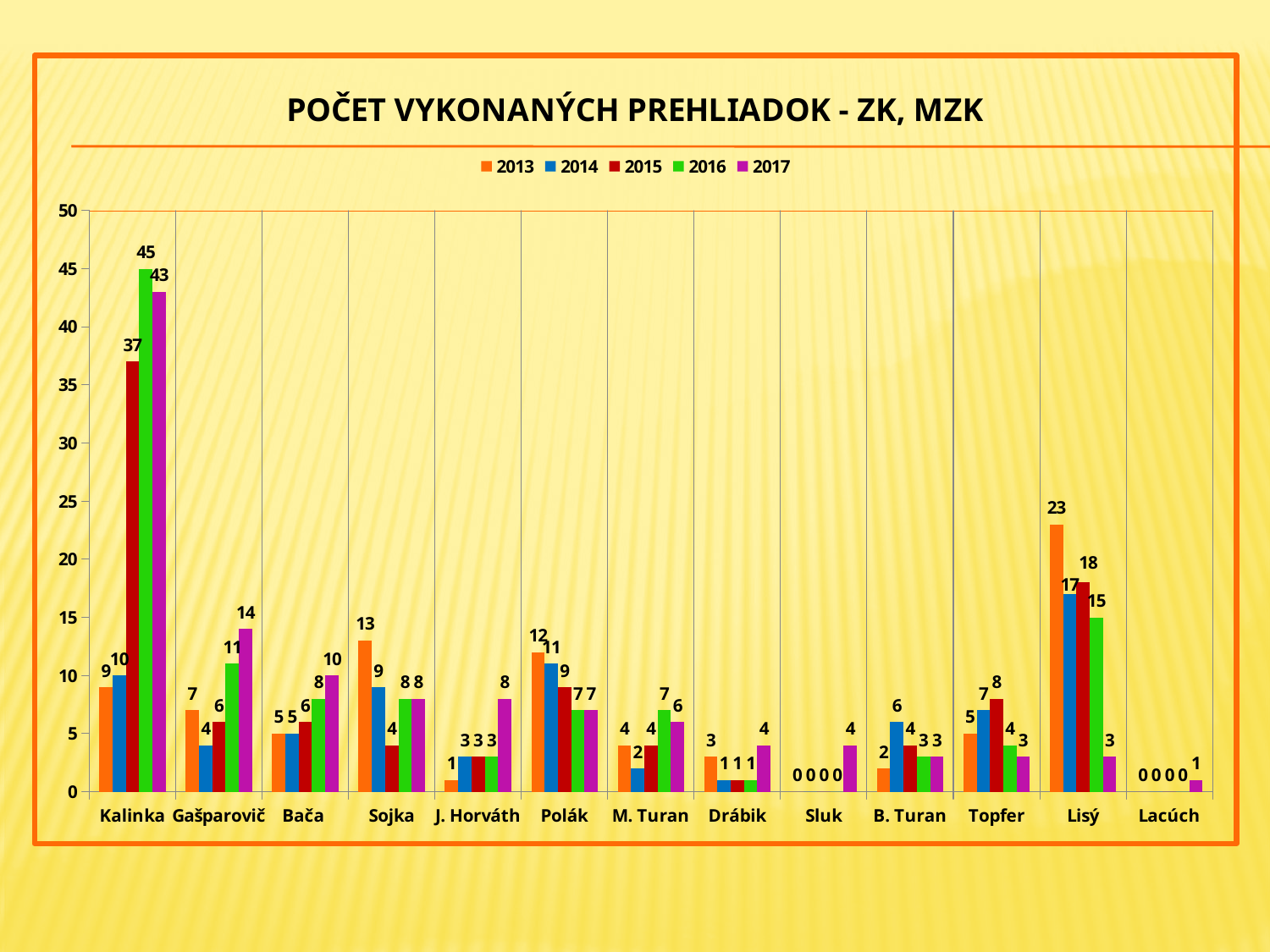
What is the value for Lisý in 2013? 23 How many categories (names) are shown on the x axis? 13 What is the value for Kalinka in 2016? 45 What is the value for Sojka in 2015? 4 What type of chart is shown on the slide? bar chart How many series does the legend list? 5 Which category has the lowest value in 2017? Lacúch Do the values for Lisý rise or fall from 2013 to 2017? fall What is the title of the chart? POČET VYKONANÝCH PREHLIADOK - ZK, MZK What is the difference between Kalinka's 2016 value and its 2015 value? 8 Which is larger: Gašparovič in 2017 or Polák in 2017? Gašparovič in 2017 Which category has the highest value in 2017? Kalinka